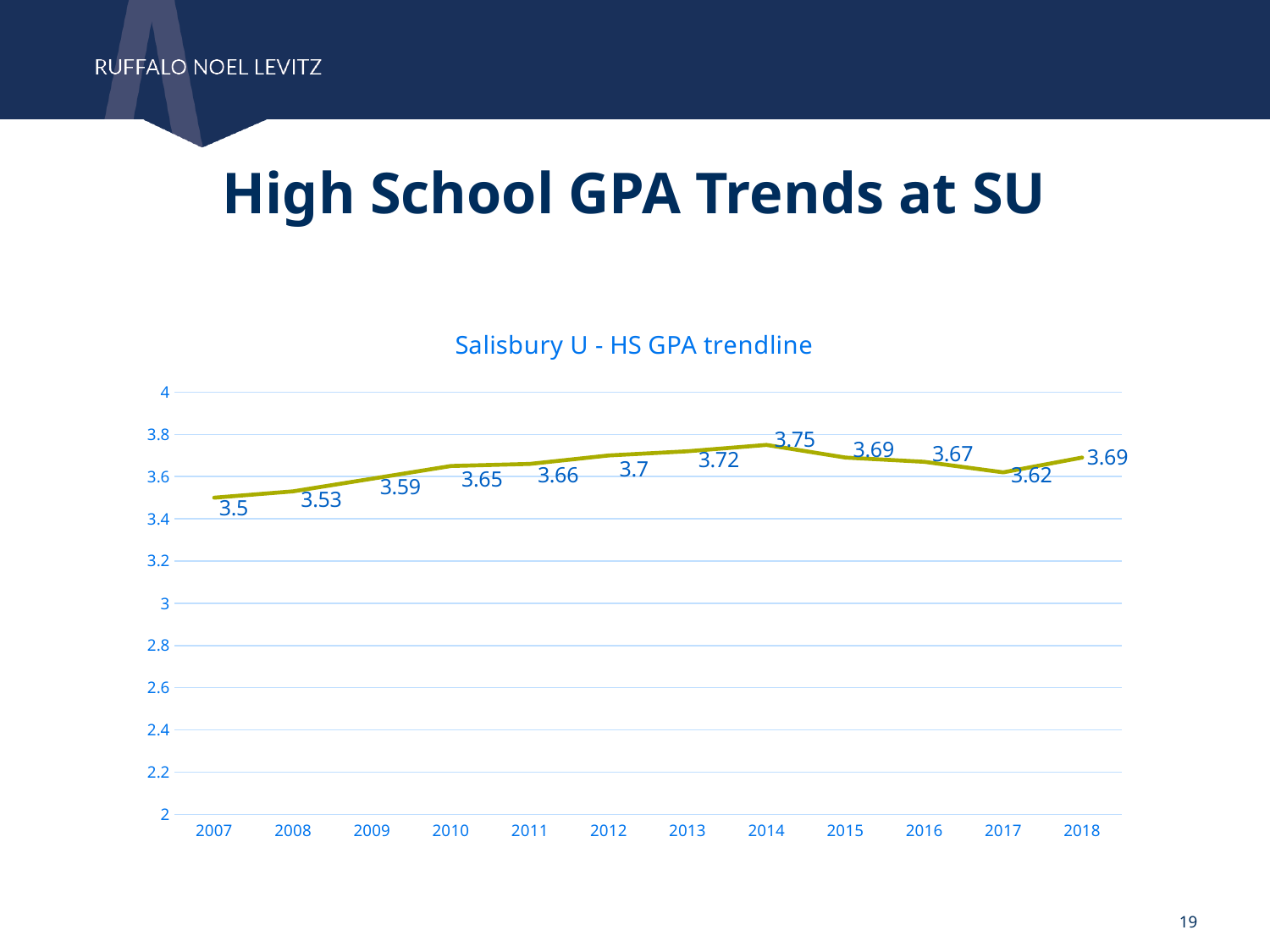
Which year has a higher HS GPA value, 2010 or 2016? 2016 What is the title of the chart? Salisbury U - HS GPA trendline What kind of chart is shown on the slide? line chart How many years are plotted on the chart? 12 What is the HS GPA value for 2007? 3.5 What is the difference between the HS GPA values for 2014 and 2007? 0.25 Which year has the lowest HS GPA value? 2007 What is the HS GPA value for 2014? 3.75 Is the value for 2013 greater or less than 3.6? greater Which year has the highest HS GPA value? 2014 What is the HS GPA value for 2012? 3.7 What is the HS GPA value for 2017? 3.62